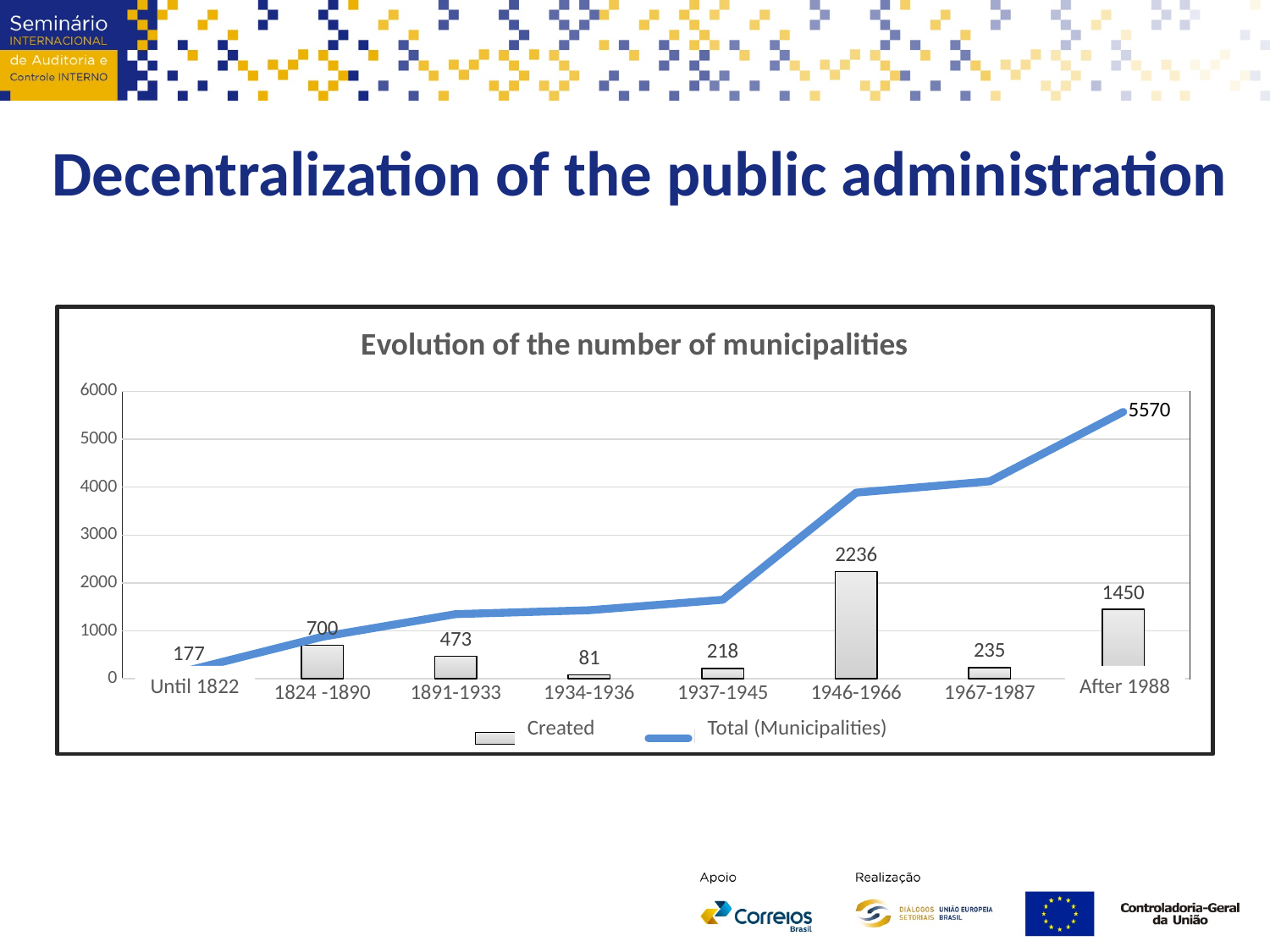
What is the value of the Total (Municipalities) line for After 1988? 5570 How many municipalities were created in the period 1946-1966? 2236 What is the title of the chart? Evolution of the number of municipalities Which period had more municipalities created, 1824 -1890 or 1891-1933? 1824 -1890 How many municipalities were created in the period 1934-1936? 81 How many periods are shown on the x axis? 8 Which period has the highest number of municipalities created? 1946-1966 What is the difference between the number of municipalities created in 1946-1966 and After 1988? 786 Does the Total (Municipalities) line rise or fall across the periods from Until 1822 to After 1988? rise Which period has the lowest number of municipalities created? 1934-1936 How many series does the legend list? 2 Is the Total (Municipalities) value for 1946-1966 greater or less than 3000? greater